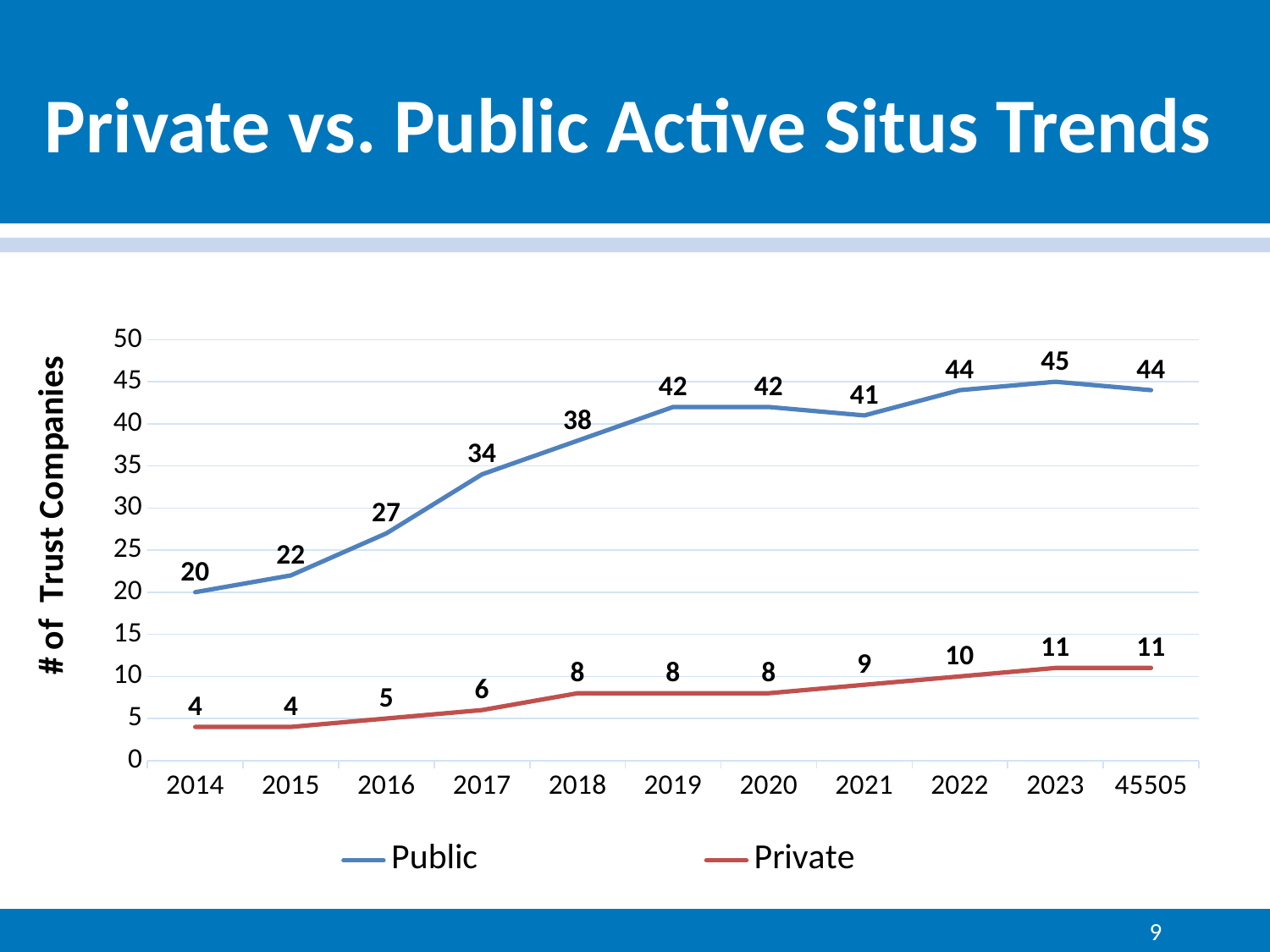
How many series does the legend list? 2 What kind of chart is shown on the slide? Line chart In which year is the Public series highest? 2023 What is the Private value for 2021? 9 What is the title of the slide? Private vs. Public Active Situs Trends What is the lowest value in the Private series? 4 Which is larger, the Public value for 2016 or the Public value for 2018? 2018 What is the label on the vertical axis? # of Trust Companies What is the difference between the Public and Private values in 2019? 34 Does the Private series generally rise or fall from 2014 to 2023? Rise What is the Public value for 2014? 20 What is the Public value for 2017? 34